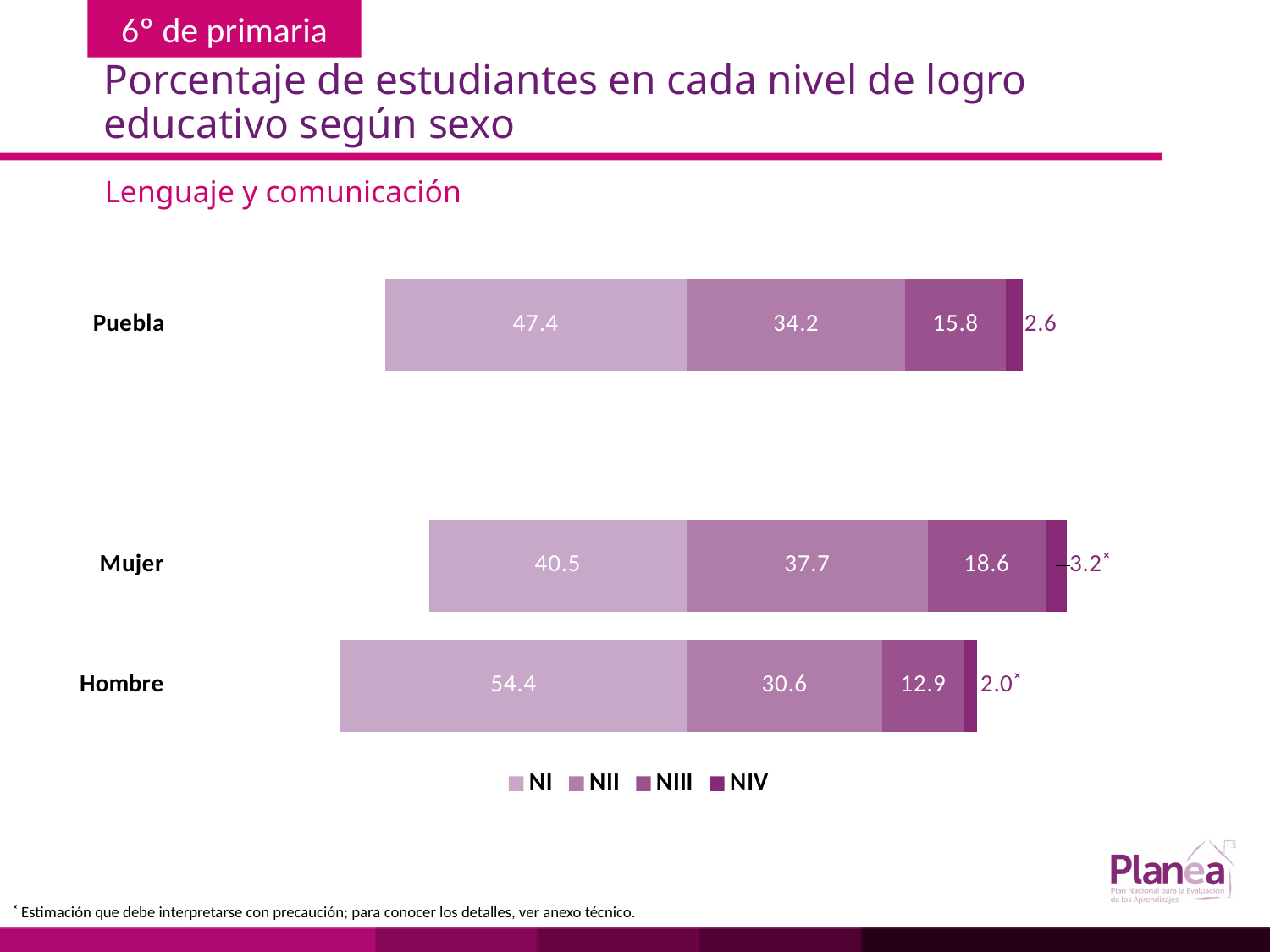
What is the NII value for Mujer? 37.7 How many series does the legend list? 4 What is the NIV value for Mujer? 3.2 What is the difference between the NI values for Hombre and Mujer? 13.9 What is the NIII value for Puebla? 15.8 What is the total of the stacked bar for Puebla? 100.0 What is the NI value for Hombre? 54.4 What kind of chart is shown on the slide? Stacked bar chart Which category has the lowest NIII value? Hombre How many categories are shown on the chart? 3 Which category has the highest NI value? Hombre Which is larger, the NII value for Puebla or the NII value for Hombre? Puebla